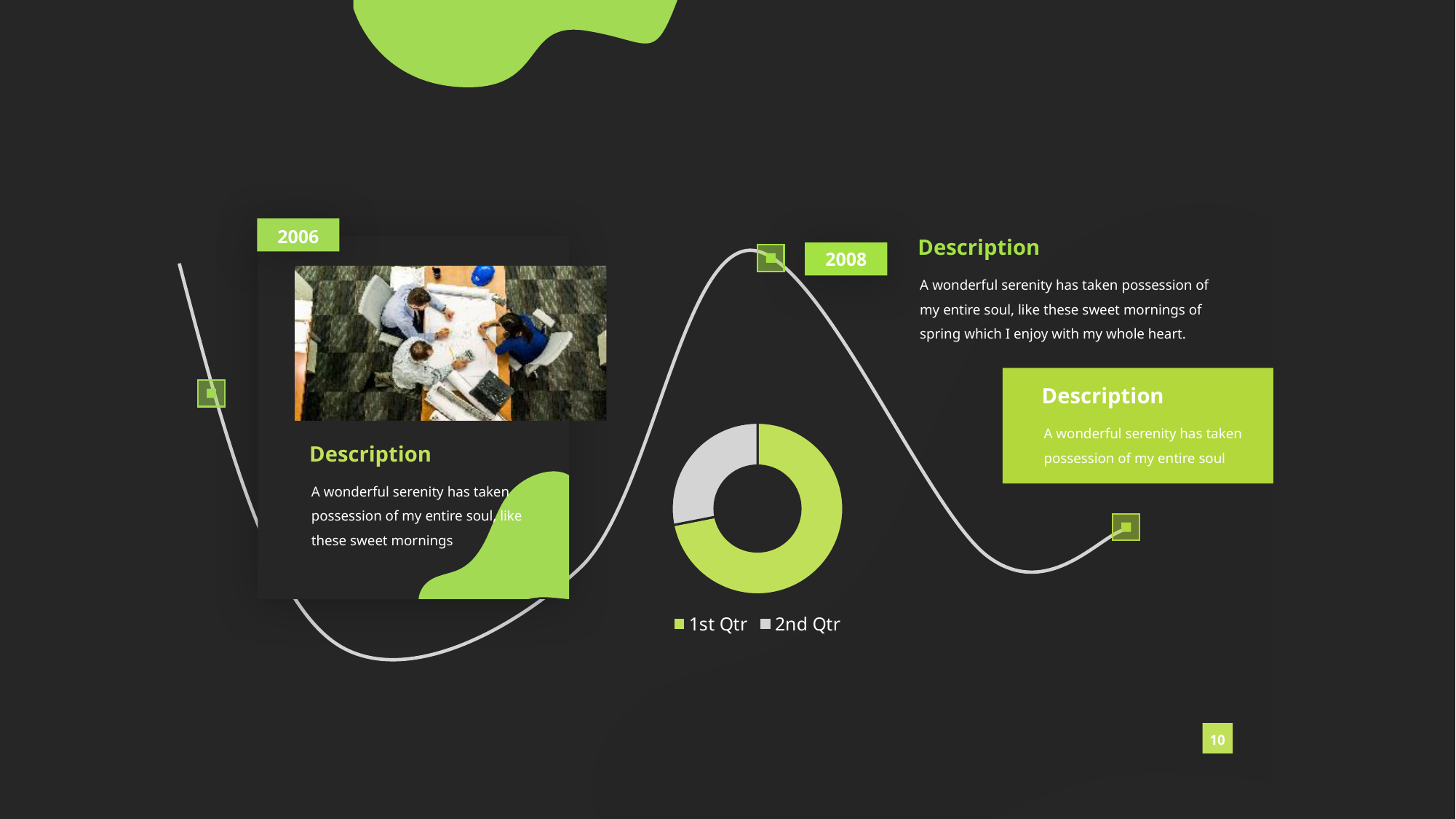
What kind of chart is shown on the slide? doughnut chart Which slice of the doughnut chart is the smallest? 2nd Qtr Which is larger in the doughnut chart, 1st Qtr or 2nd Qtr? 1st Qtr How many slices does the doughnut chart have? 2 Which slice of the doughnut chart is the largest? 1st Qtr What colour represents 1st Qtr in the doughnut chart? green How many entries does the legend of the doughnut chart list? 2 What colour represents 2nd Qtr in the doughnut chart? grey